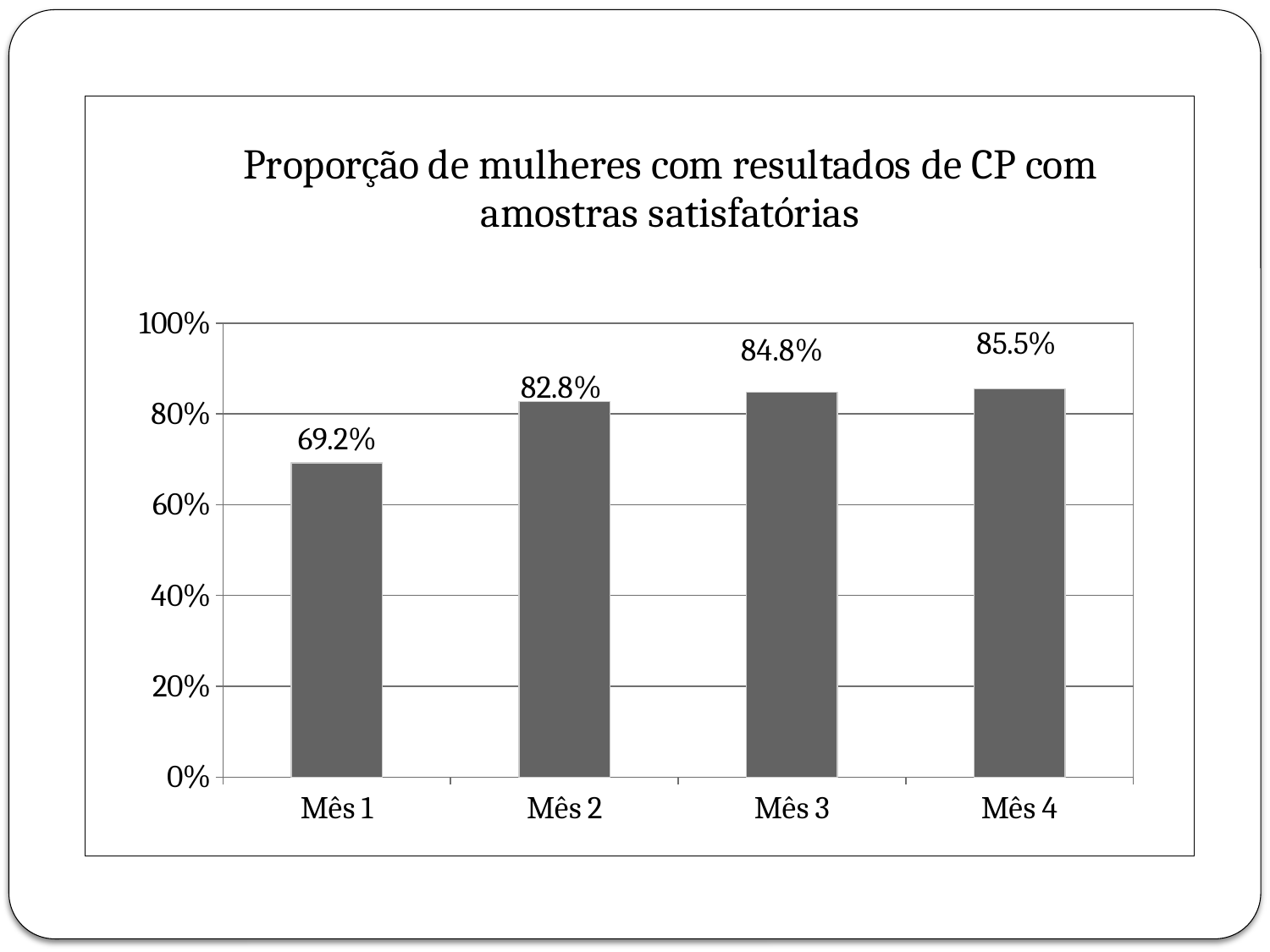
What is the value for Mês 1? 69.2% What is the value for Mês 2? 82.8% What is the difference between the values for Mês 4 and Mês 3? 0.7% Which month has the highest value? Mês 4 Which is larger, the value for Mês 1 or the value for Mês 2? Mês 2 Which month has the lowest value? Mês 1 Is the value for Mês 1 greater or less than 80%? less What is the difference between the values for Mês 2 and Mês 1? 13.6% How many months are shown on the x axis? 4 What kind of chart is this? bar chart What is the value for Mês 3? 84.8% What is the value for Mês 4? 85.5%